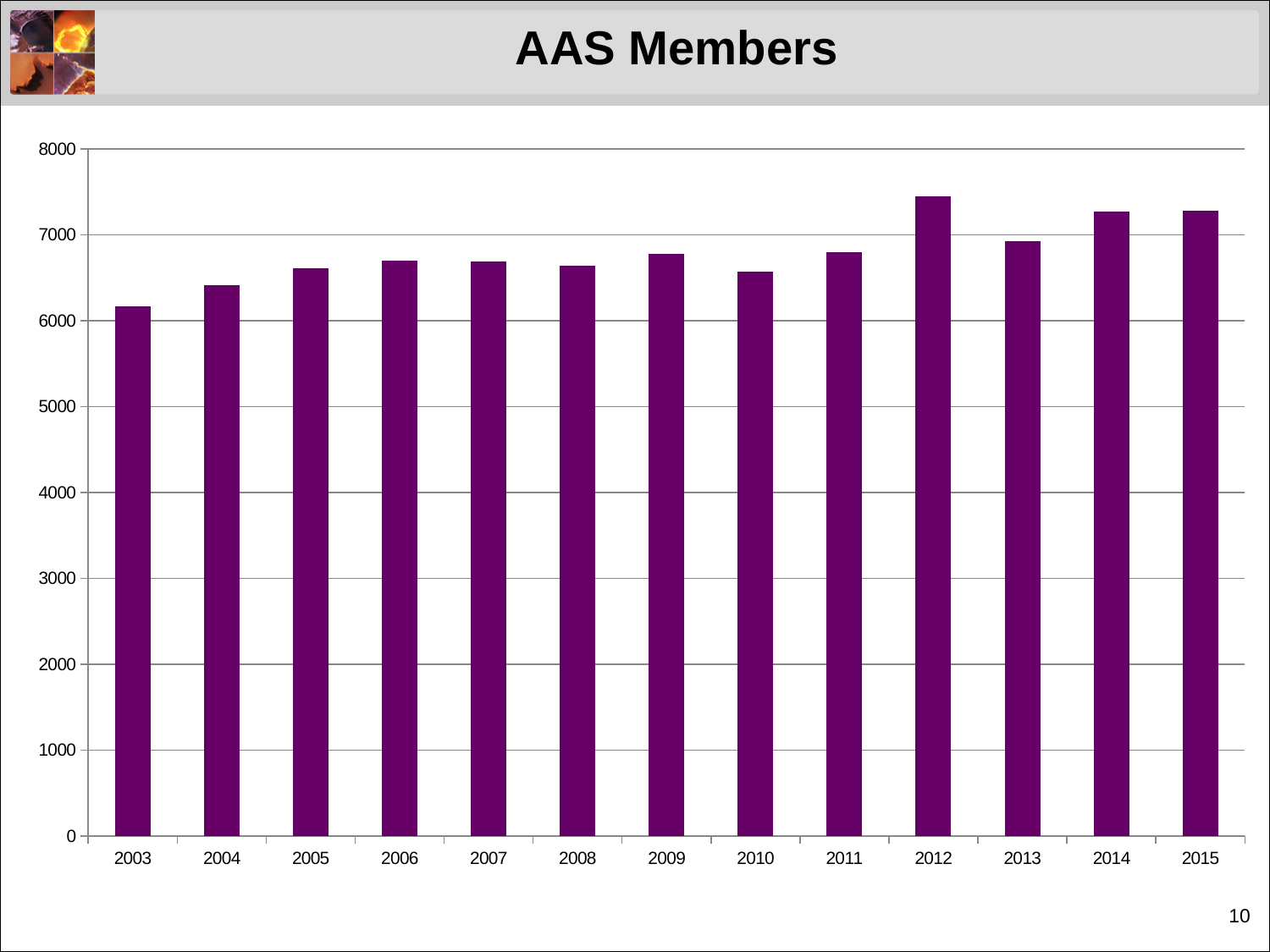
Which year has the lowest number of AAS members? 2003 Which is larger, the value for 2003 or the value for 2004? 2004 Is the value for 2012 greater or less than 7000? greater Which year has the highest number of AAS members? 2012 What kind of chart is shown on the slide? Bar chart Is the value for 2010 greater or less than 7000? less What is the title of the chart? AAS Members Overall, do the values rise or fall from 2003 to 2015? Rise Is the value for 2003 greater or less than 6000? greater Which is larger, the value for 2012 or the value for 2013? 2012 How many years are shown on the x axis of the chart? 13